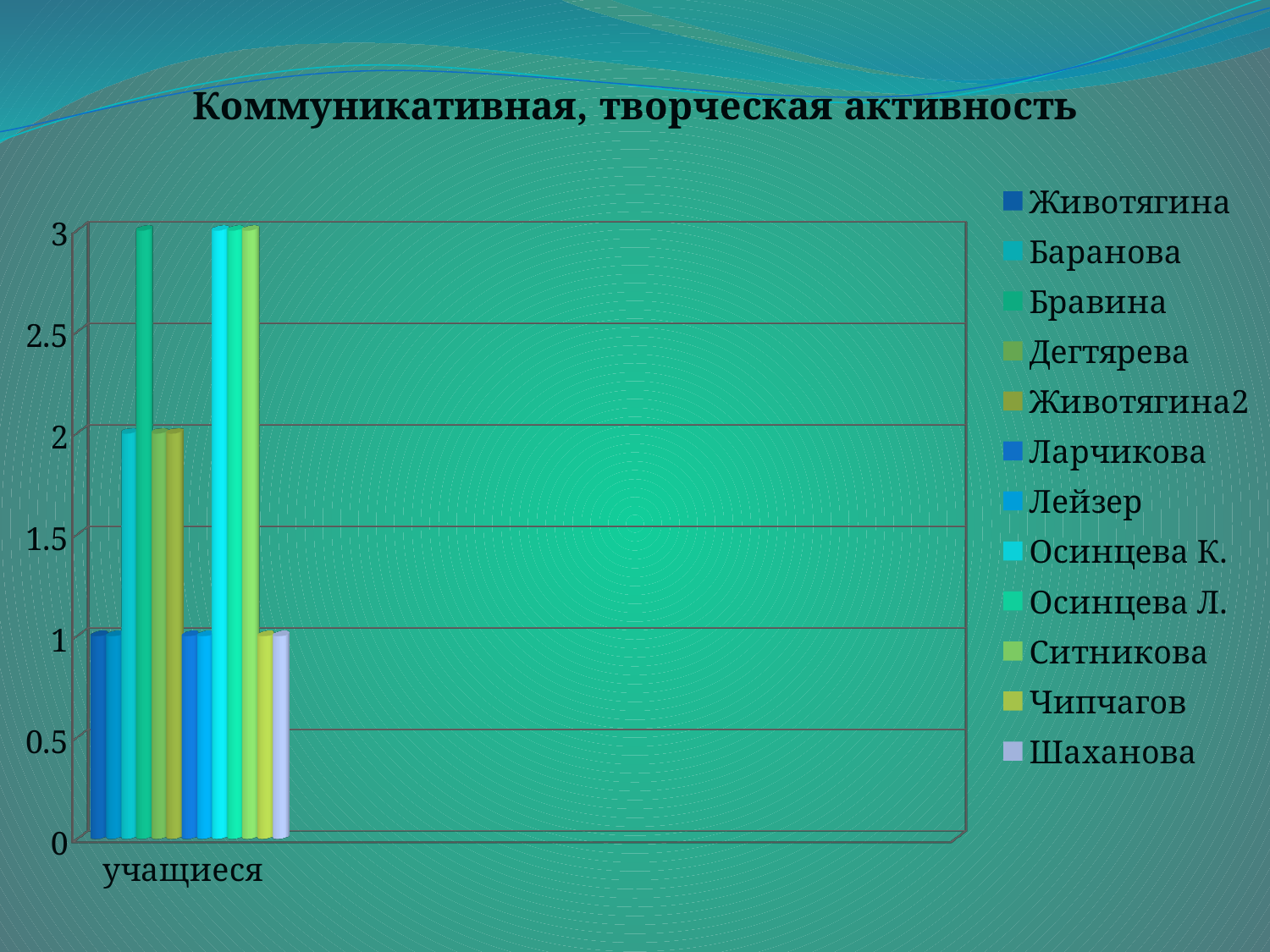
What kind of chart is shown on the slide? bar chart What is the title of the chart? Коммуникативная, творческая активность Which is larger, the value for Бравина or the value for Животягина? Бравина Is the value for Дегтярева greater or less than 1.5? greater What is the value for Шаханова? 1 How many series does the legend list? 12 What is the value for Бравина? 3 What is the difference between the value for Ситникова and the value for Чипчагов? 2 Is the value for Лейзер greater or less than 2? less How many categories are shown on the x axis? 1 What is the value for Баранова? 2 What is the label of the category on the x axis? учащиеся